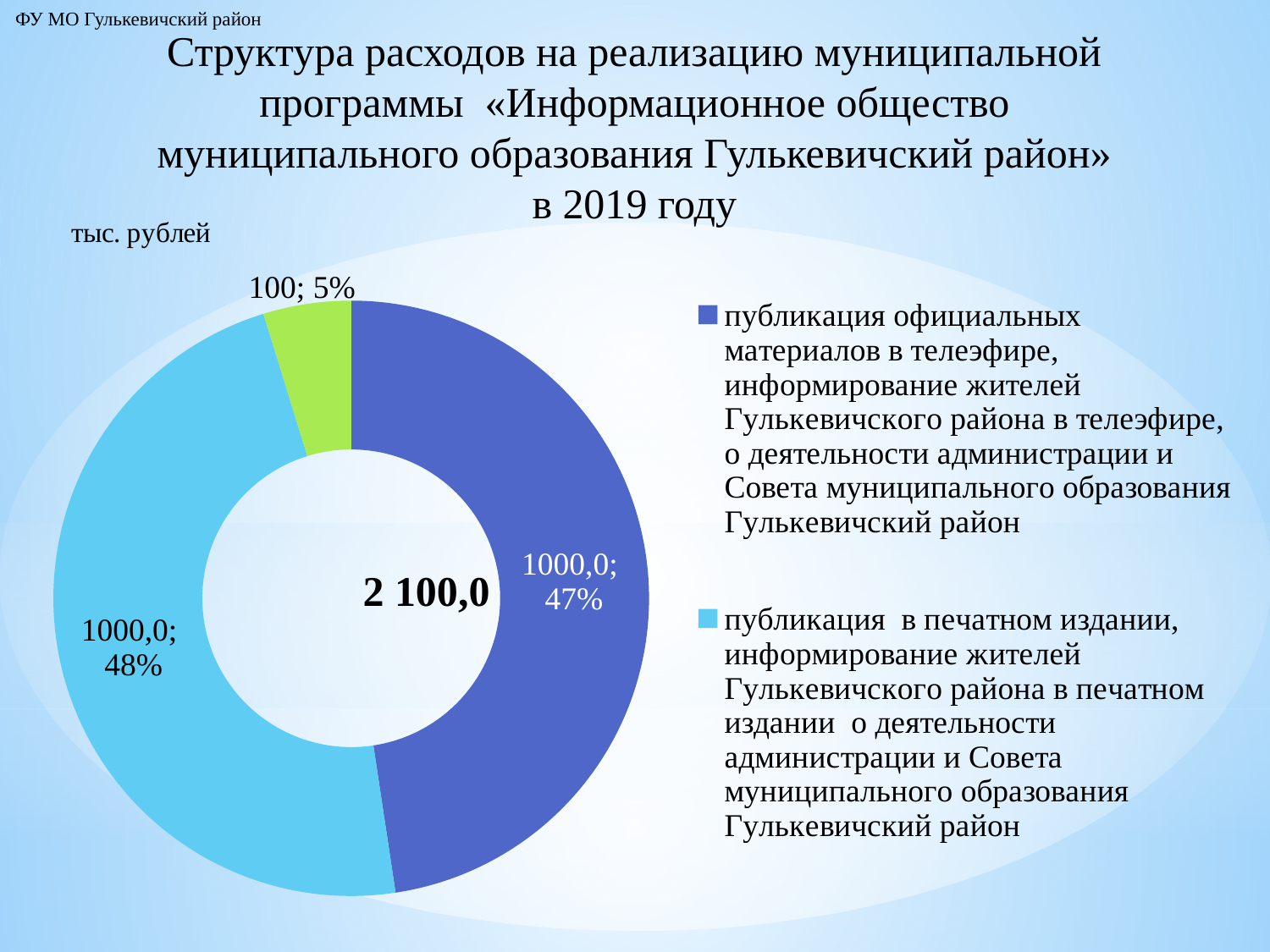
What share of the chart does the slice 'публикация в печатном издании...' (light blue) represent? 48% In what units are the chart values given, according to the label above the chart? тыс. рублей What kind of chart is shown on the slide? doughnut (pie) chart What is the value shown for the slice 'публикация официальных материалов в телеэфире...' (dark blue)? 1000,0 What total value is shown in the centre of the doughnut chart? 2 100,0 How many entries does the legend list? 2 How many slices does the doughnut chart have? 3 What is the value shown for the slice 'публикация в печатном издании...' (light blue)? 1000,0 What is the value of the smallest slice in the chart? 100 What share of the chart does the slice 'публикация официальных материалов в телеэфире...' (dark blue) represent? 47% What is the difference between the value of the dark blue slice (1000,0) and the green slice (100)? 900 What share of the chart does the green slice represent? 5%